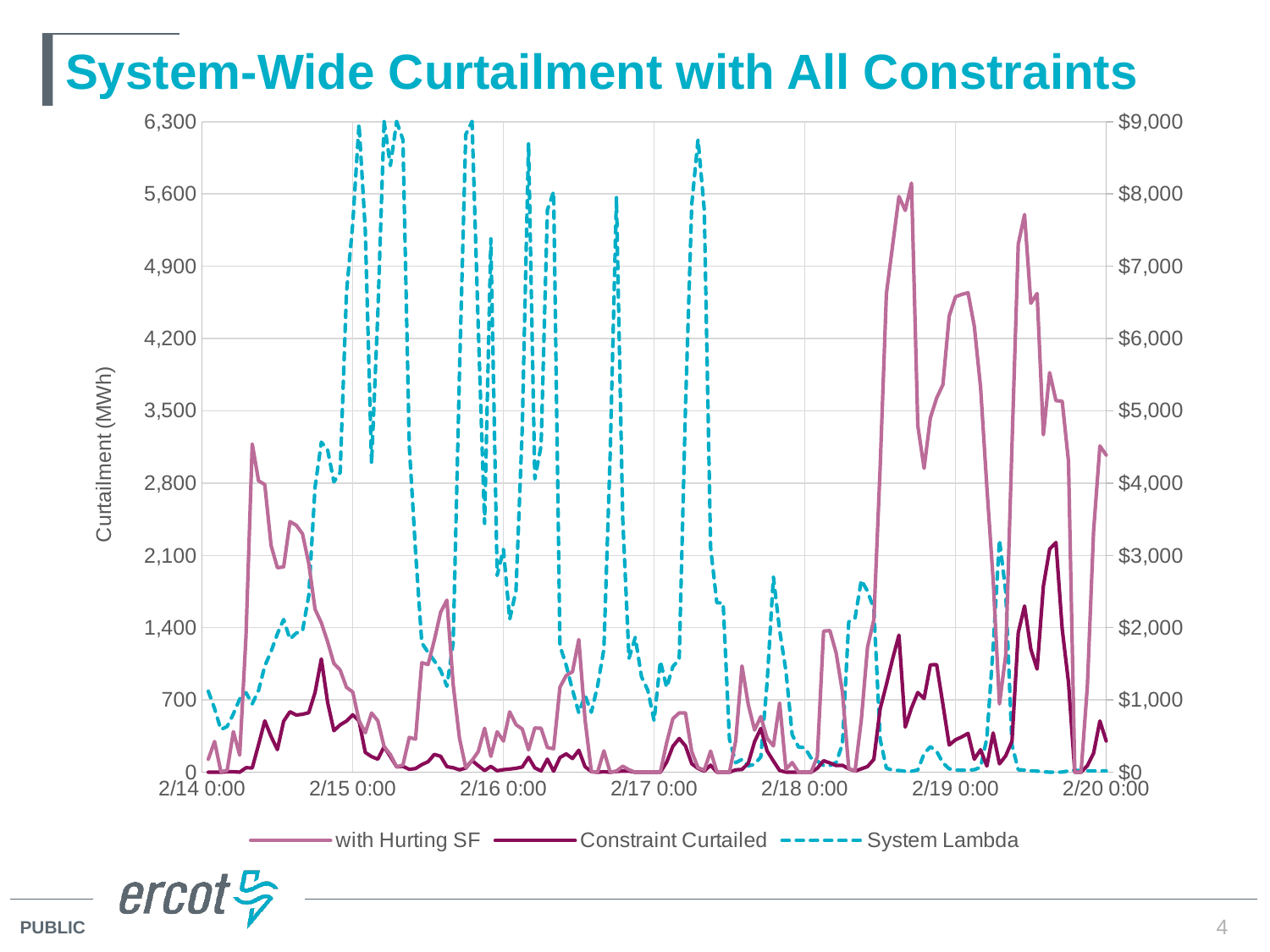
Which series reaches a higher peak on the left axis, 'with Hurting SF' or 'Constraint Curtailed'? with Hurting SF What is the label of the left vertical axis? Curtailment (MWh) Is the value of 'System Lambda' at 2/19 0:00 greater or less than $1,000? less What is the title of the chart? System-Wide Curtailment with All Constraints Is the value of 'with Hurting SF' at 2/17 0:00 greater or less than 700? less Is the highest value reached by the 'Constraint Curtailed' series greater or less than 2,800? less How many series does the legend list? 3 What kind of chart is shown on the slide? Line chart How many date labels are shown along the x axis? 7